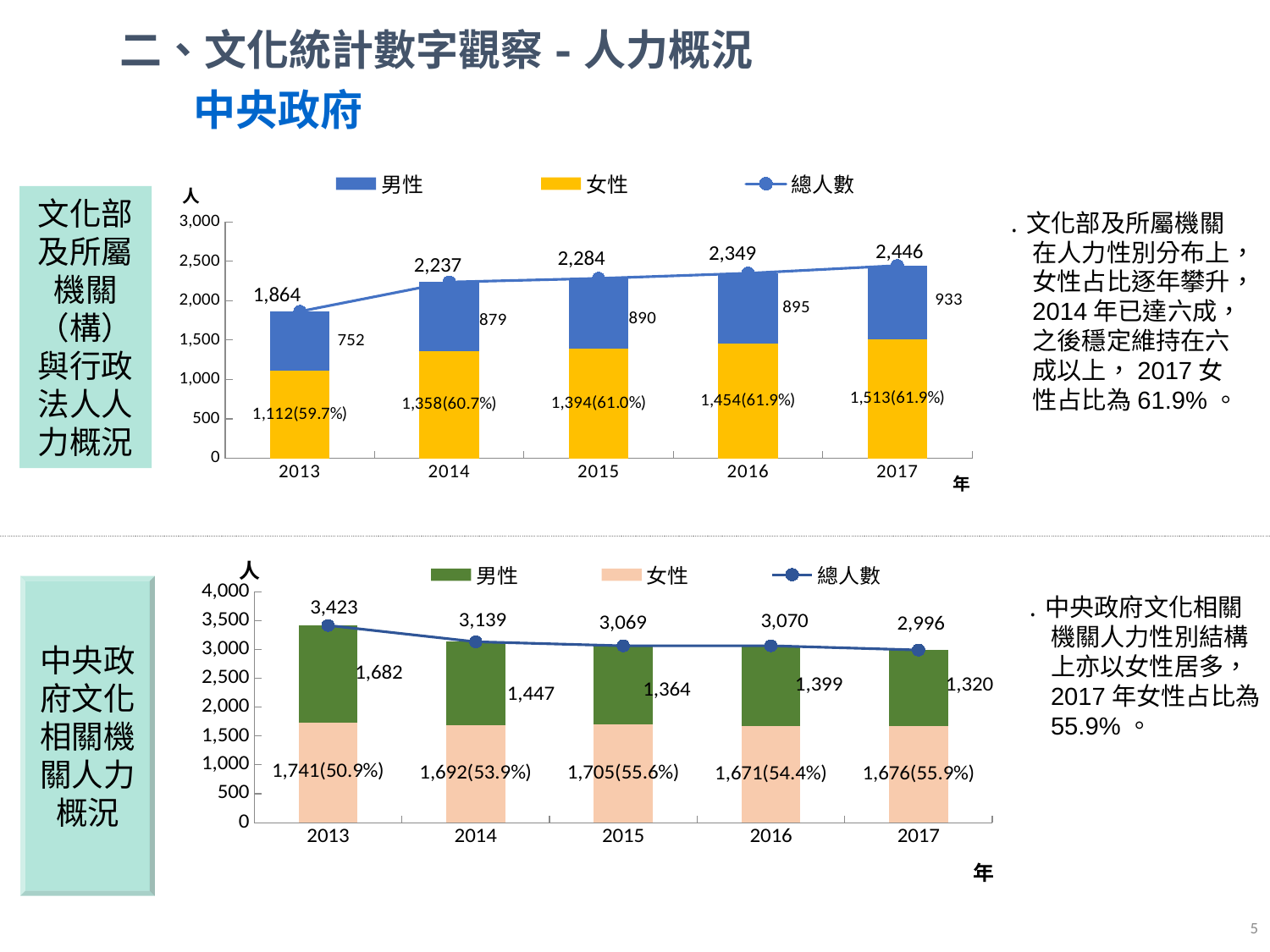
In the bottom chart (中央政府文化相關機關人力概況), what is the 總人數 value for 2013? 3,423 How many years are shown on the x axis of the top chart? 5 In the bottom chart, what is the 男性 value for 2015? 1,364 In the top chart, what is the difference between the 總人數 values for 2017 and 2013? 582 In the top chart, does 總人數 rise or fall from 2013 to 2017? rise In the top chart (文化部及所屬機關（構）與行政法人人力概況), what is the 總人數 value for 2017? 2,446 How many series does the legend of the bottom chart list? 3 In the top chart, what is the 男性 value for 2013? 752 In the bottom chart, which is larger, the 男性 value for 2014 or the 男性 value for 2017? 2014 In the top chart, what is the data label on the 女性 bar for 2016? 1,454(61.9%) In the bottom chart, which year has the highest 總人數? 2013 In the top chart, which year has the lowest 總人數? 2013